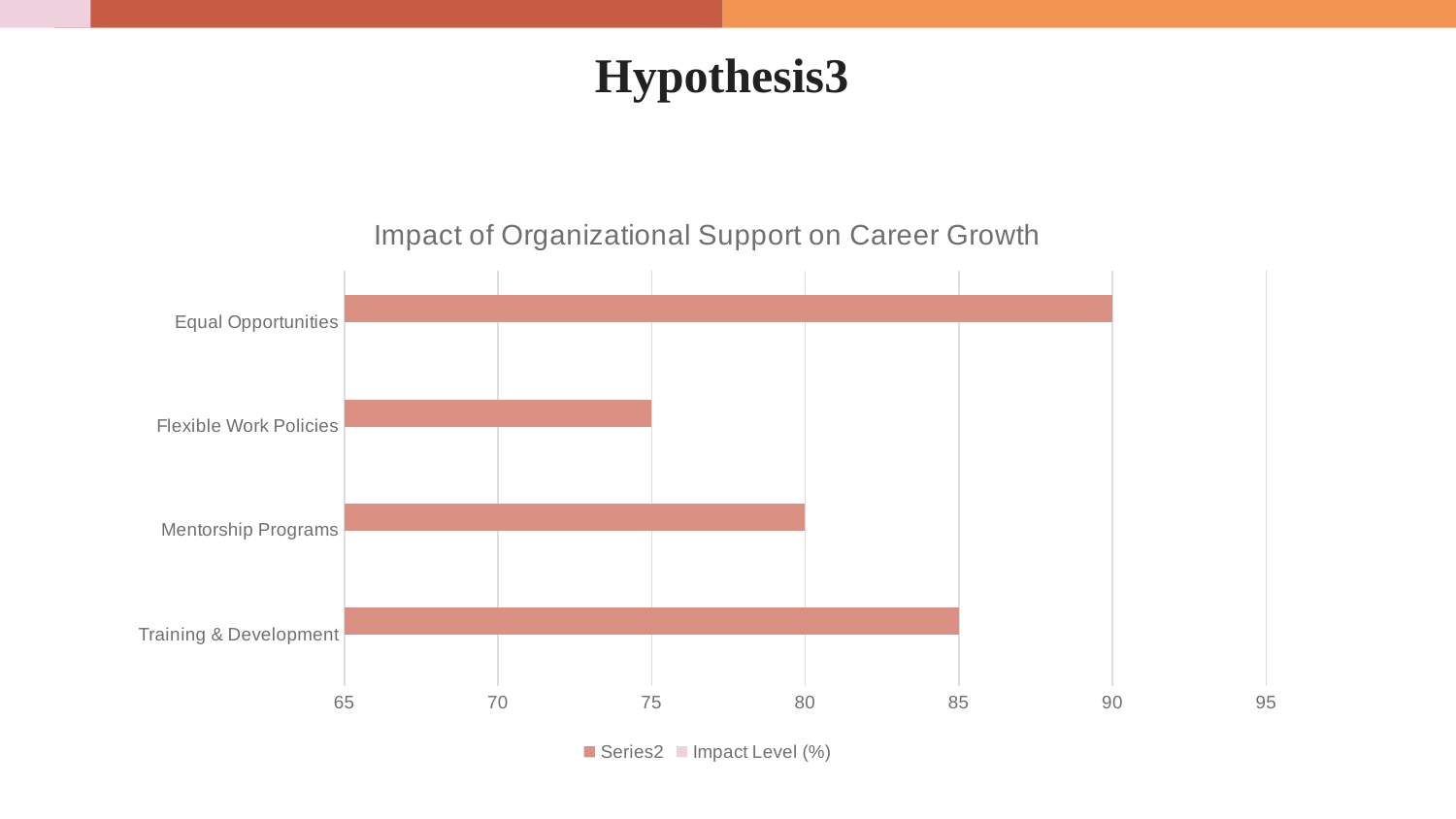
What is the difference between the values for Equal Opportunities and Flexible Work Policies? 15 What is the value for Flexible Work Policies? 75 Which category has the highest value? Equal Opportunities What is the value for Mentorship Programs? 80 What is the title of the chart? Impact of Organizational Support on Career Growth Which is larger, the value for Mentorship Programs or the value for Training & Development? Training & Development Which category has the lowest value? Flexible Work Policies How many series does the legend list? 2 How many categories are shown on the chart? 4 What is the value for Training & Development? 85 What is the value for Equal Opportunities? 90 What kind of chart is shown on the slide? Bar chart